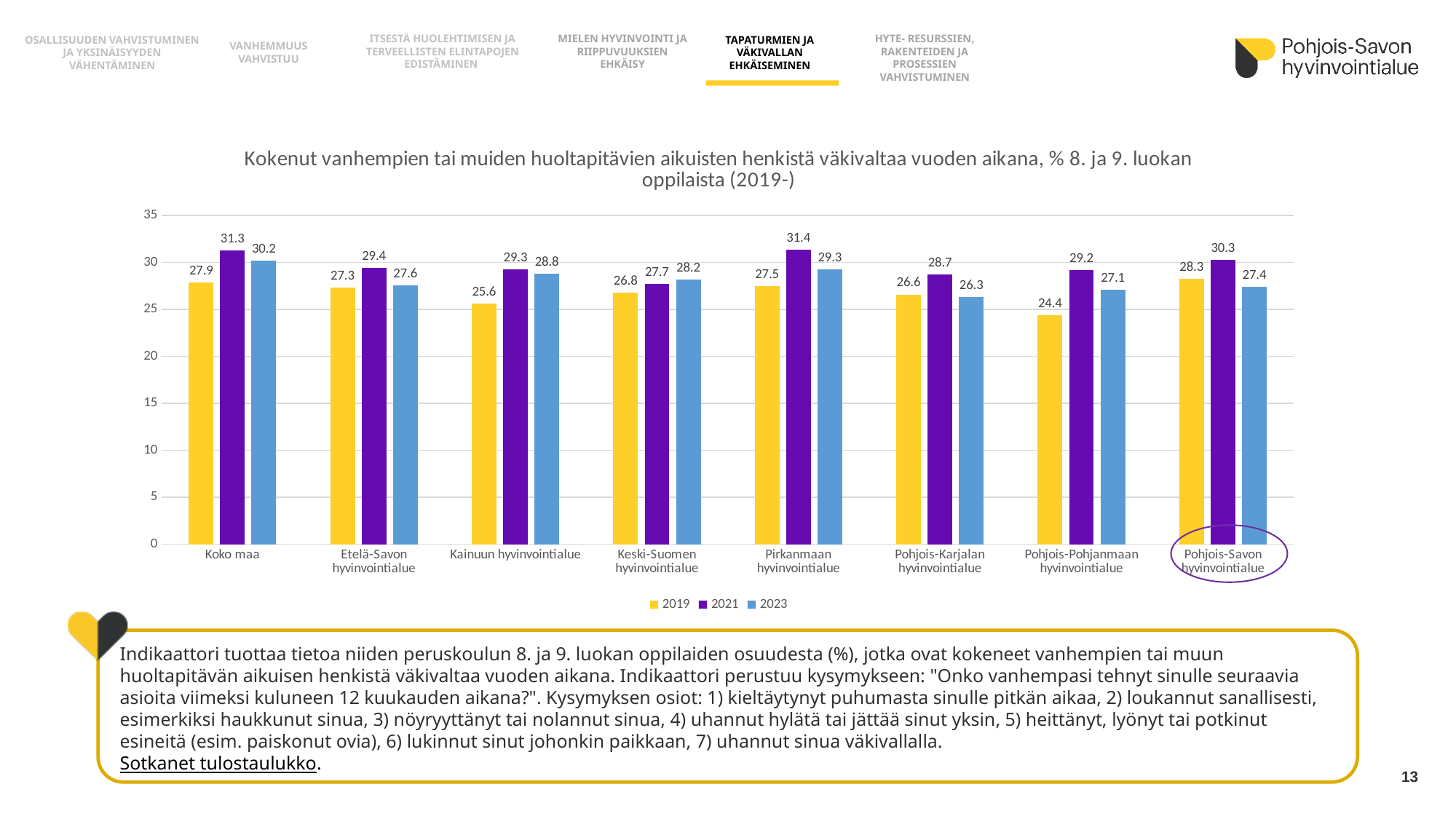
Is the 2021 value for Koko maa greater or less than 30? greater What kind of chart is shown on the slide? bar chart What is the 2023 value for Keski-Suomen hyvinvointialue? 28.2 What is the 2019 value for Pohjois-Pohjanmaan hyvinvointialue? 24.4 Which category has the lowest 2019 value? Pohjois-Pohjanmaan hyvinvointialue How many series does the legend list? 3 What is the 2021 value for Pohjois-Savon hyvinvointialue? 30.3 How many categories are shown on the x axis? 8 What is the difference between the 2021 and 2023 values for Pohjois-Savon hyvinvointialue? 2.9 What is the difference between the 2021 and 2019 values for Koko maa? 3.4 Which category has the highest 2023 value? Koko maa For Kainuun hyvinvointialue, which is larger: the 2019 value or the 2023 value? 2023